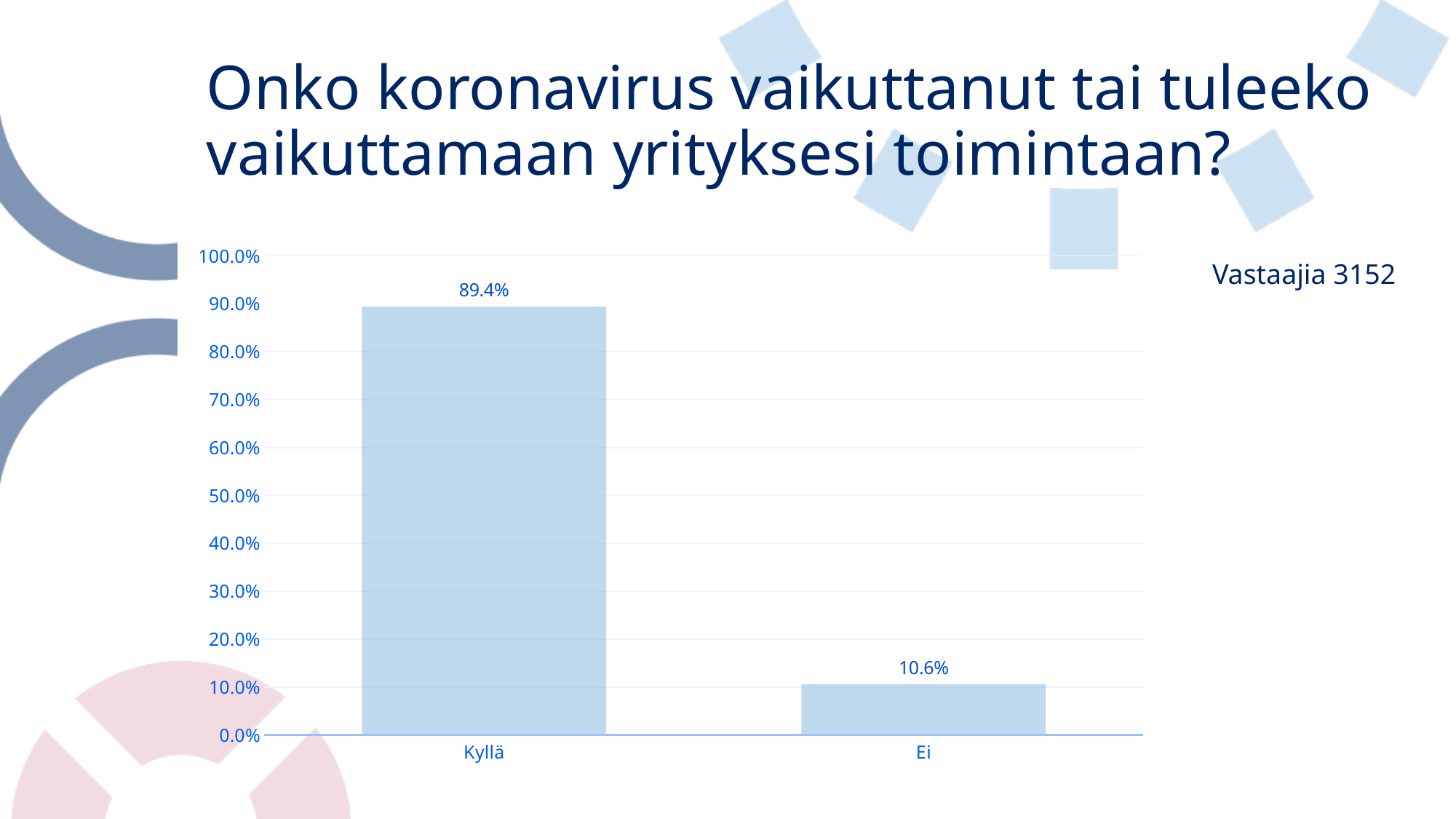
Which is larger, the value for Kyllä or the value for Ei? Kyllä Which category has the highest value? Kyllä What is the value for Kyllä? 89.4% How many categories are shown on the x axis? 2 What is the difference between the values for Kyllä and Ei? 78.8% Is the value for Kyllä greater or less than 80.0%? greater Which category has the lowest value? Ei What is the value for Ei? 10.6% How many respondents (Vastaajia) are stated on the slide? 3152 What kind of chart is shown on the slide? bar chart Is the value for Ei greater or less than 20.0%? less What is the total of the values for Kyllä and Ei? 100.0%